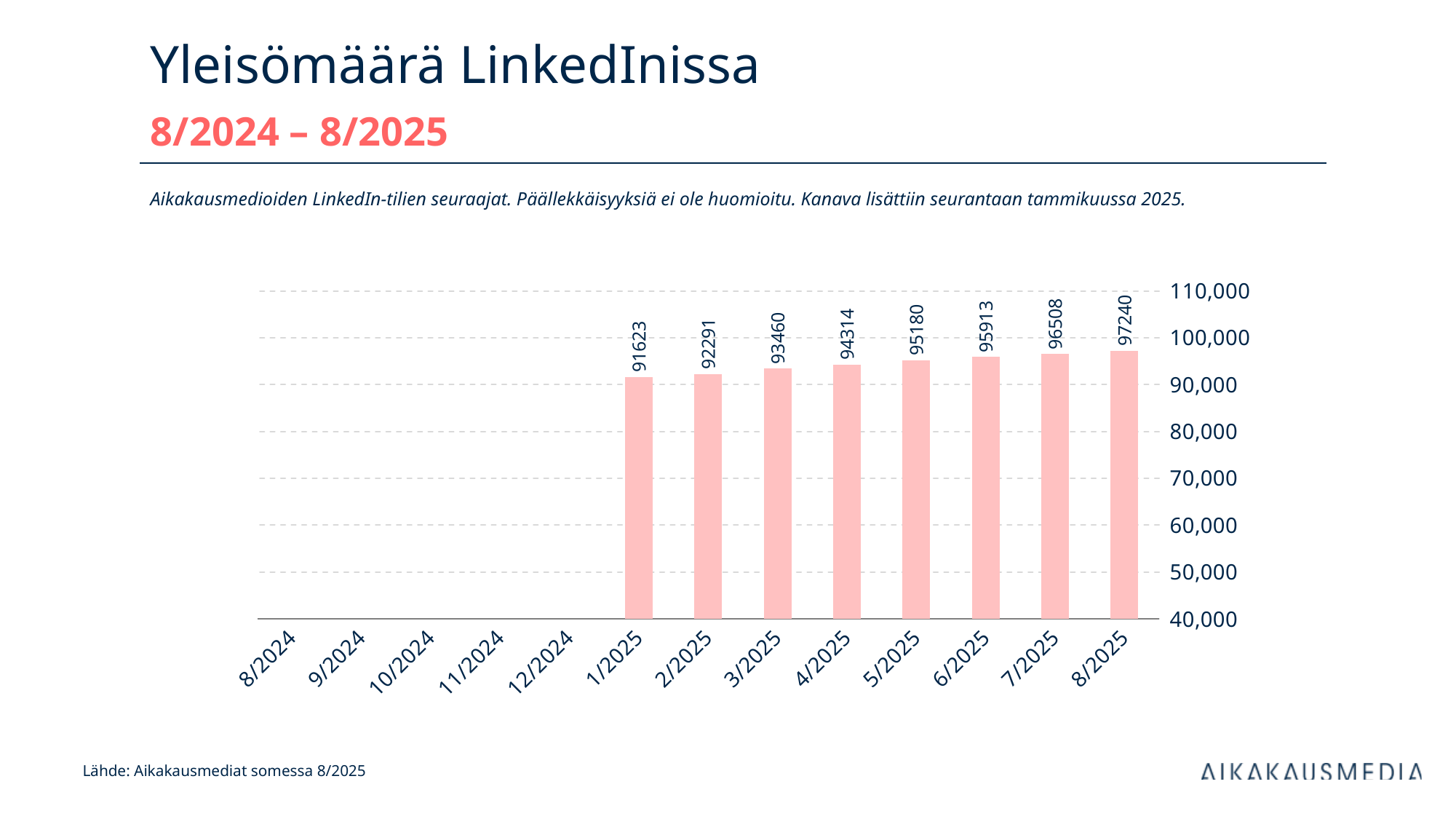
Which is larger, the value for 3/2025 or the value for 7/2025? 7/2025 Among the months with a plotted bar, which has the lowest value? 1/2025 What is the difference between the values for 6/2025 and 5/2025? 733 What is the difference between the values for 8/2025 and 1/2025? 5617 Do the values rise or fall from 1/2025 to 8/2025? rise Is the value for 2/2025 greater or less than 90,000? greater What is the value for 4/2025? 94314 What kind of chart is shown on the slide? bar chart What is the value for 8/2025? 97240 Which month has the highest value? 8/2025 What is the value for 1/2025? 91623 How many months have a plotted bar in the chart? 8